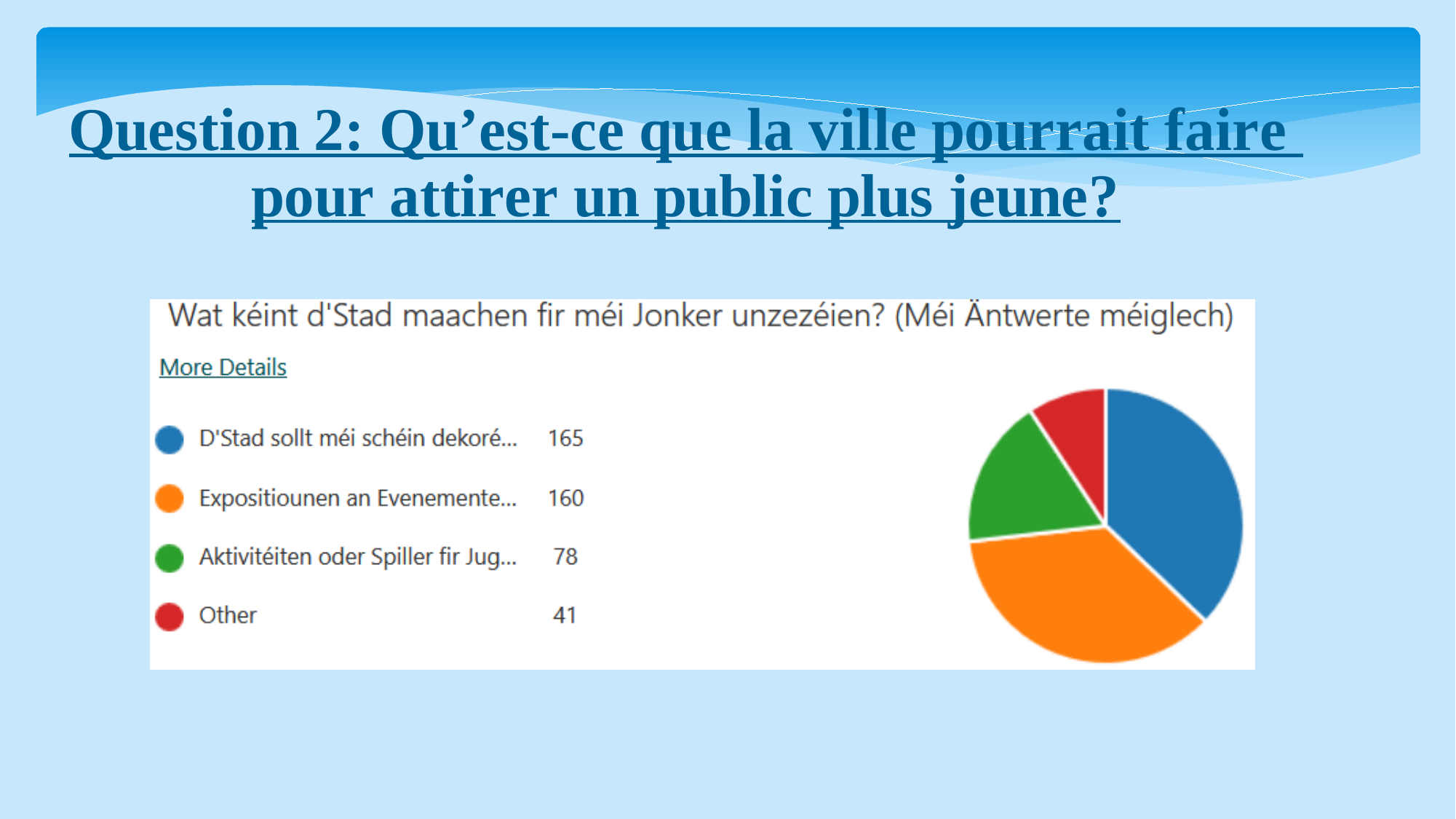
What is the value for "Expositiounen an Evenemente..."? 160 What is the value for "Other"? 41 Which category has the lowest value? Other What is the difference between the values for "Aktivitéiten oder Spiller fir Jug..." and "Other"? 37 How many categories does the pie chart have? 4 What is the difference between the values for "D'Stad sollt méi schéin dekoré..." and "Expositiounen an Evenemente..."? 5 What is the value for "D'Stad sollt méi schéin dekoré..."? 165 What type of chart is shown on the slide? pie chart What colour is the slice for "Other" in the pie chart? red Which category has the highest value? D'Stad sollt méi schéin dekoré... What is the value for "Aktivitéiten oder Spiller fir Jug..."? 78 Which is larger, the value for "Expositiounen an Evenemente..." or the value for "Aktivitéiten oder Spiller fir Jug..."? Expositiounen an Evenemente...